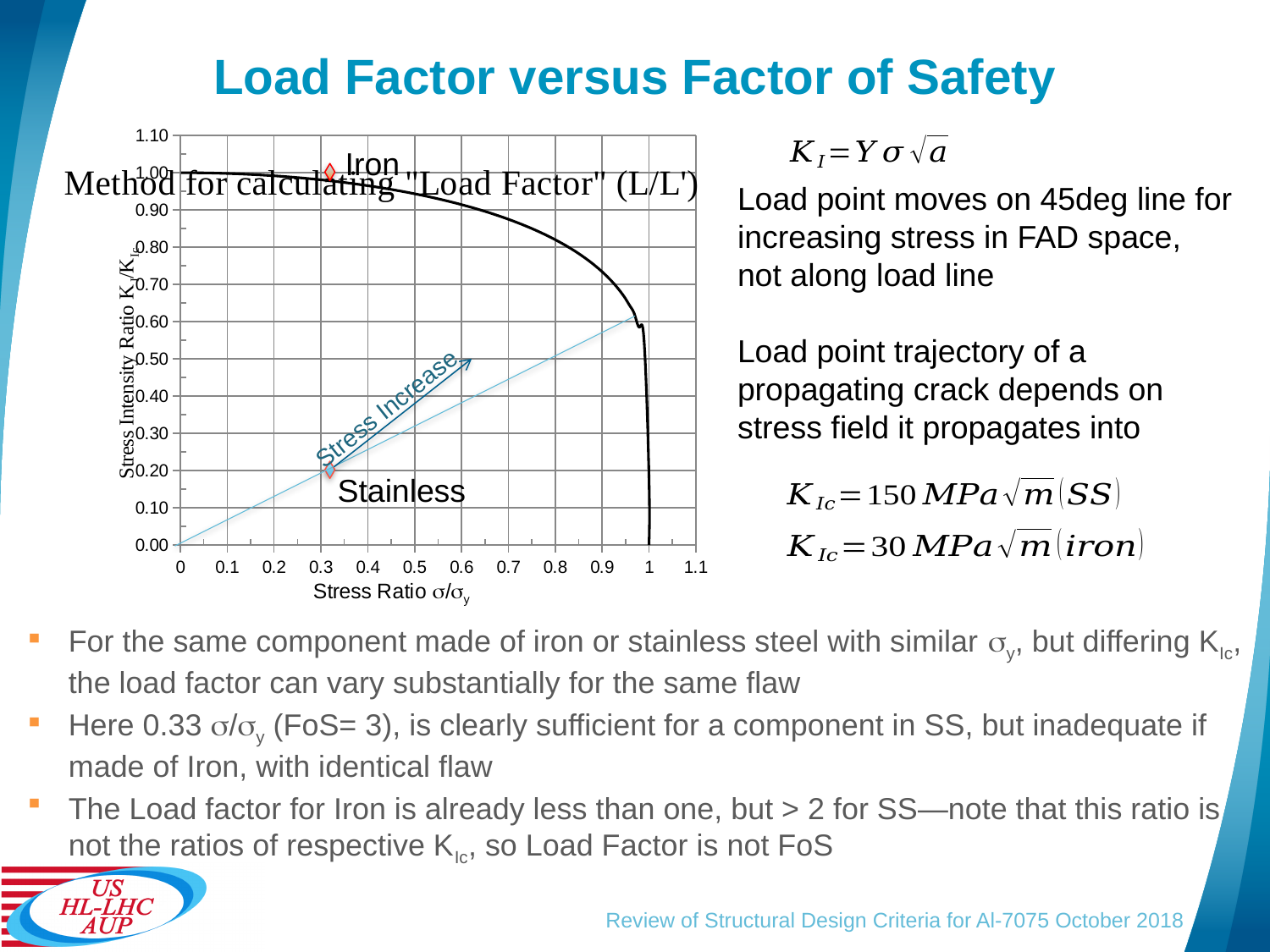
What kind of chart is shown on the slide? line chart Which marked point has the higher stress intensity ratio, Iron or Stainless? Iron Is the stress ratio for the Stainless point greater or less than 0.5? less What is the maximum value shown on the x axis of the chart? 1.1 How many labeled data points (materials) are marked on the chart? 2 Which marked material has the lowest stress intensity ratio on the chart? Stainless Is the stress intensity ratio for Stainless greater or less than 0.30? less What is the maximum value shown on the y axis of the chart? 1.10 What is the label of the x axis of the chart? Stress Ratio σ/σy Does the thick failure assessment curve rise or fall as the stress ratio increases along the x axis? fall What is the label of the y axis of the chart? Stress Intensity Ratio KI/KIc Is the stress intensity ratio for Iron greater or less than 0.90? greater